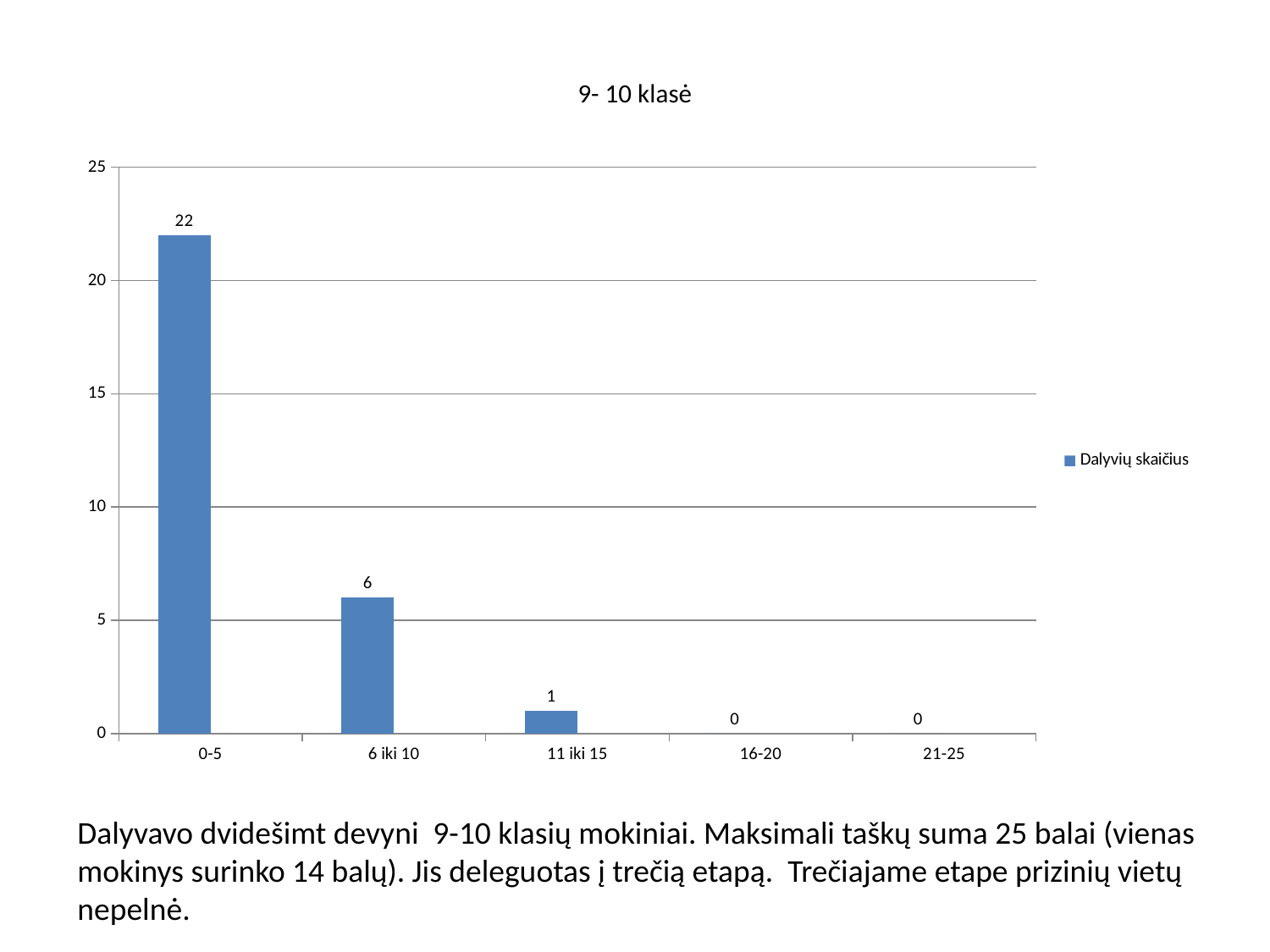
What is the value for the 16-20 category? 0 How many categories are shown on the x axis? 5 What is the value for the 11 iki 15 category? 1 What kind of chart is shown on the slide? bar chart What is the difference between the values for 0-5 and 6 iki 10? 16 How many series does the legend list? 1 What is the value for the 0-5 category? 22 Is the value for 0-5 greater or less than 20? greater Which is larger, the value for 6 iki 10 or the value for 11 iki 15? 6 iki 10 Which category has the highest value? 0-5 What is the title of the chart? 9- 10 klasė What is the value for the 6 iki 10 category? 6